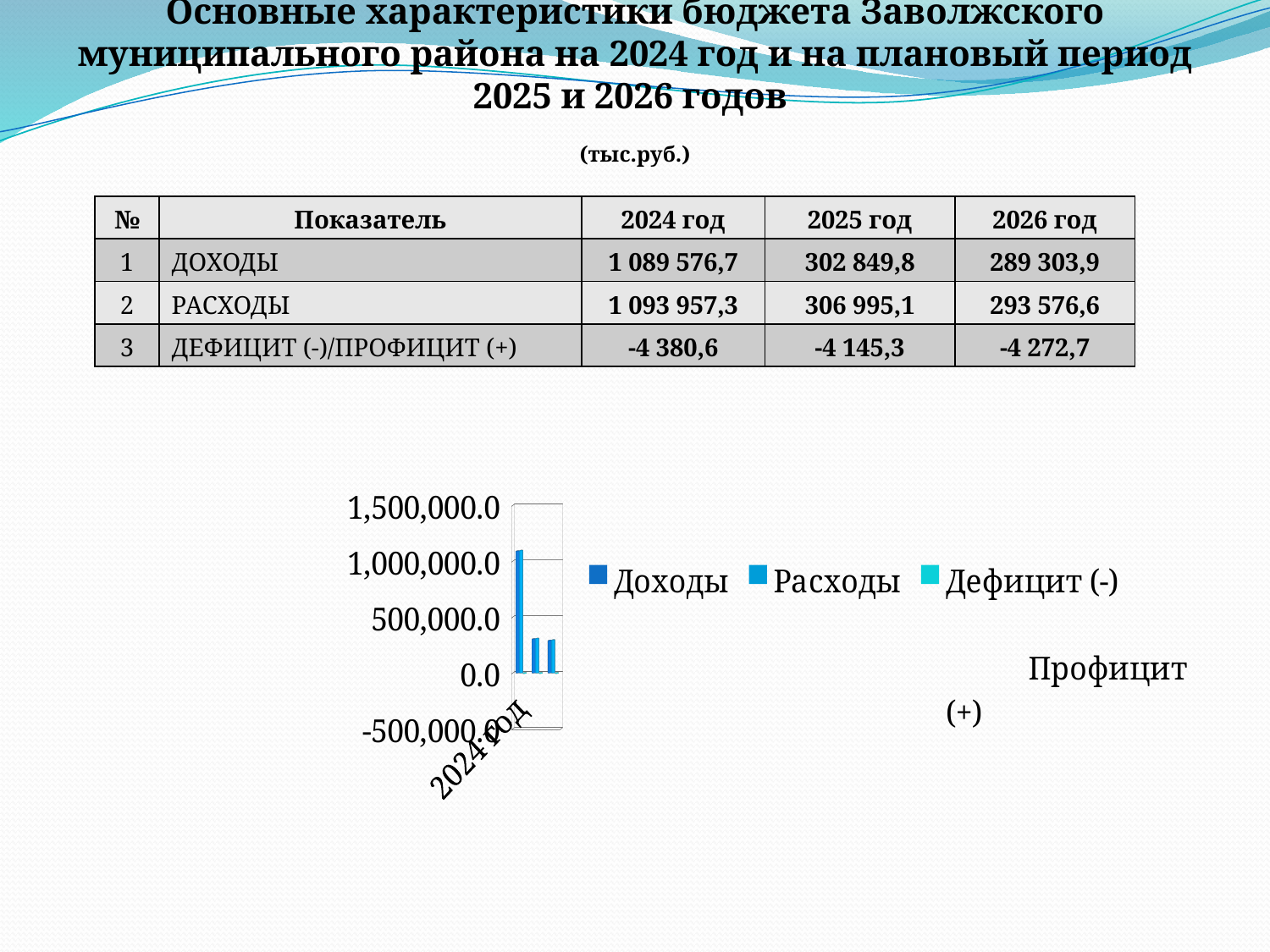
What kind of chart is shown on the slide? bar chart What is the highest tick value shown on the chart's vertical axis? 1,500,000.0 What category label is shown on the chart's horizontal axis? 2024 год How many series does the chart legend list? 3 Is the value of the tallest bar in the chart greater or less than 500,000? greater Is the value of the third bar in the chart greater or less than 500,000? less Is the value of the tallest bar in the chart greater or less than 1,000,000? greater What are the series names listed in the chart legend? Доходы, Расходы, Дефицит (-) Профицит (+)